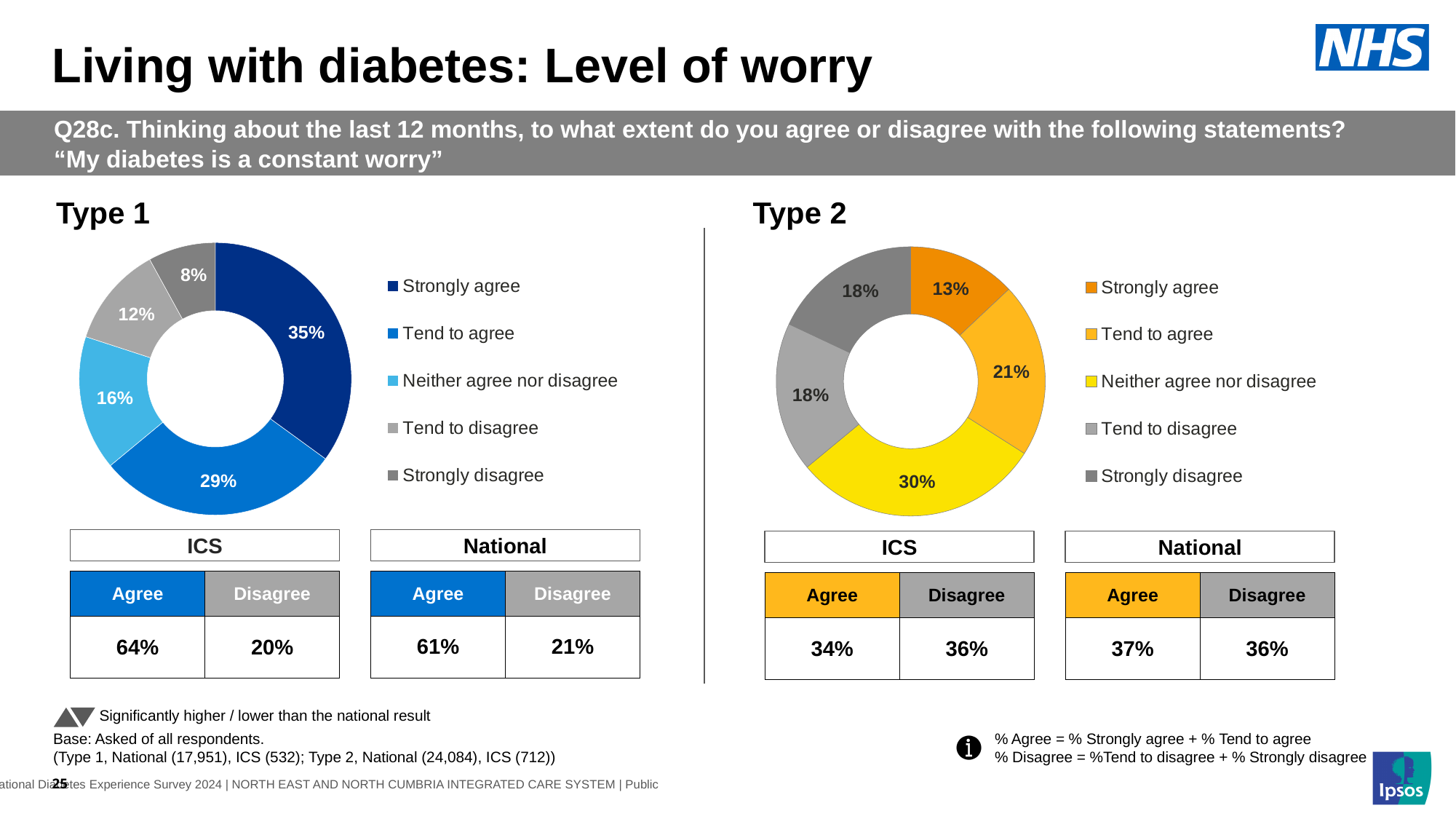
How many response categories does the legend of the Type 2 chart list? 5 In the Type 1 chart, which response category has the smallest share? Strongly disagree In the Type 2 chart, what is the difference in percentage points between 'Neither agree nor disagree' and 'Tend to agree'? 9 percentage points In the Type 1 chart, which response category has the largest share? Strongly agree Which is larger: the 'Strongly agree' share in the Type 1 chart or the 'Strongly agree' share in the Type 2 chart? Type 1 In the Type 1 chart, what percentage of respondents said they strongly agree? 35% In the Type 1 chart, what is the difference in percentage points between 'Strongly agree' and 'Tend to agree'? 6 percentage points In the Type 2 chart, what percentage of respondents said they strongly agree? 13% In the Type 2 chart, what percentage of respondents said they neither agree nor disagree? 30% What type of chart is used to show the Type 1 results? Donut (pie) chart In the Type 1 chart, what percentage of respondents said they tend to disagree? 12% In the Type 2 chart, which response category has the largest share? Neither agree nor disagree